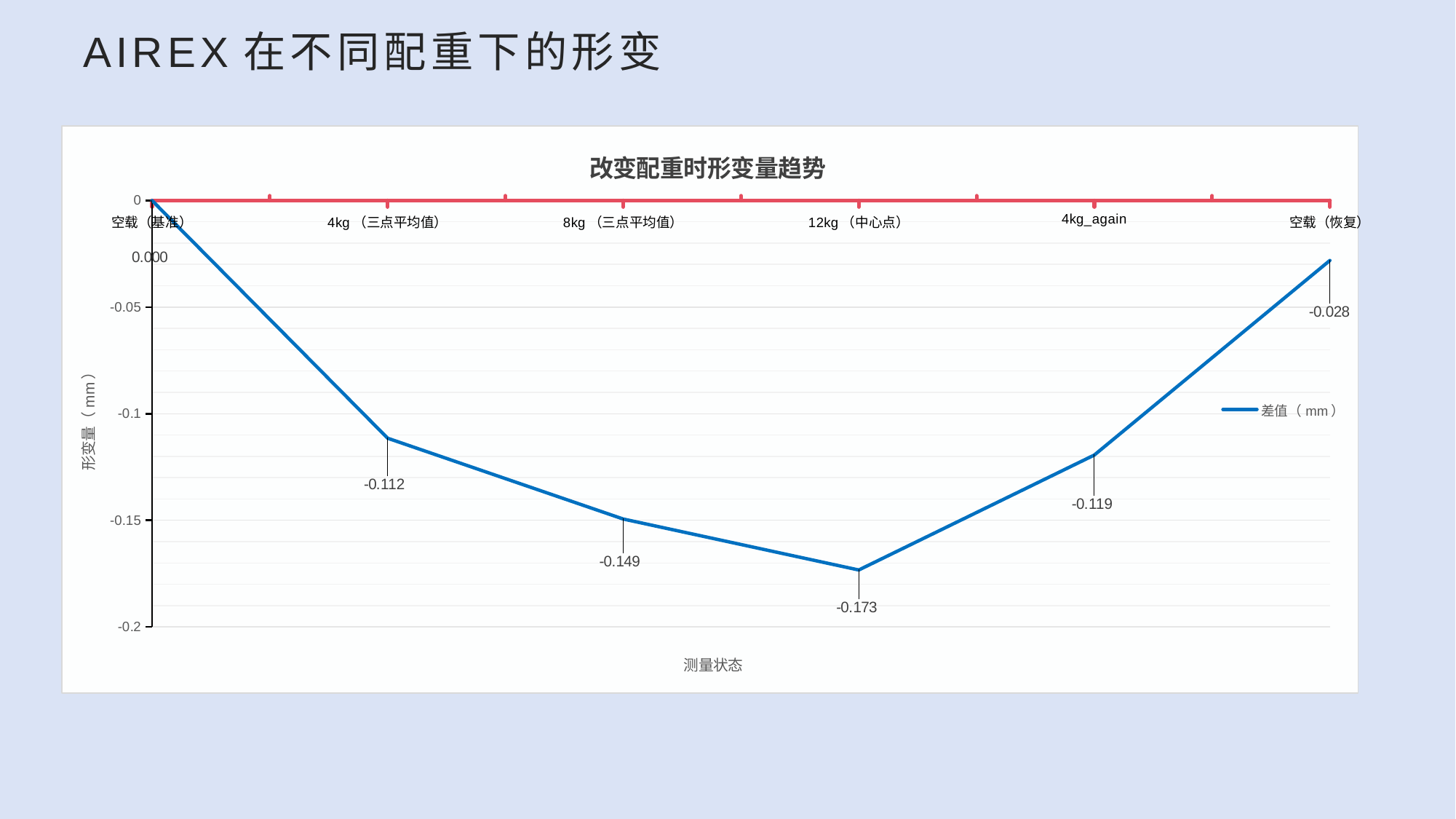
Which category has the highest value? 空载（基准） Which category has the lowest value? 12kg（中心点） What is the title of the chart? 改变配重时形变量趋势 What is the value for 空载（恢复）? -0.028 What is the value for 8kg（三点平均值）? -0.149 How many series does the legend list? 1 What is the value for 4kg（三点平均值）? -0.112 What is the difference between the values for 4kg（三点平均值） and 4kg_again? 0.007 What kind of chart is this? line chart What is the value for 12kg（中心点）? -0.173 How many categories are plotted on the x axis? 6 Which is larger, the value for 8kg（三点平均值） or the value for 4kg_again? 4kg_again